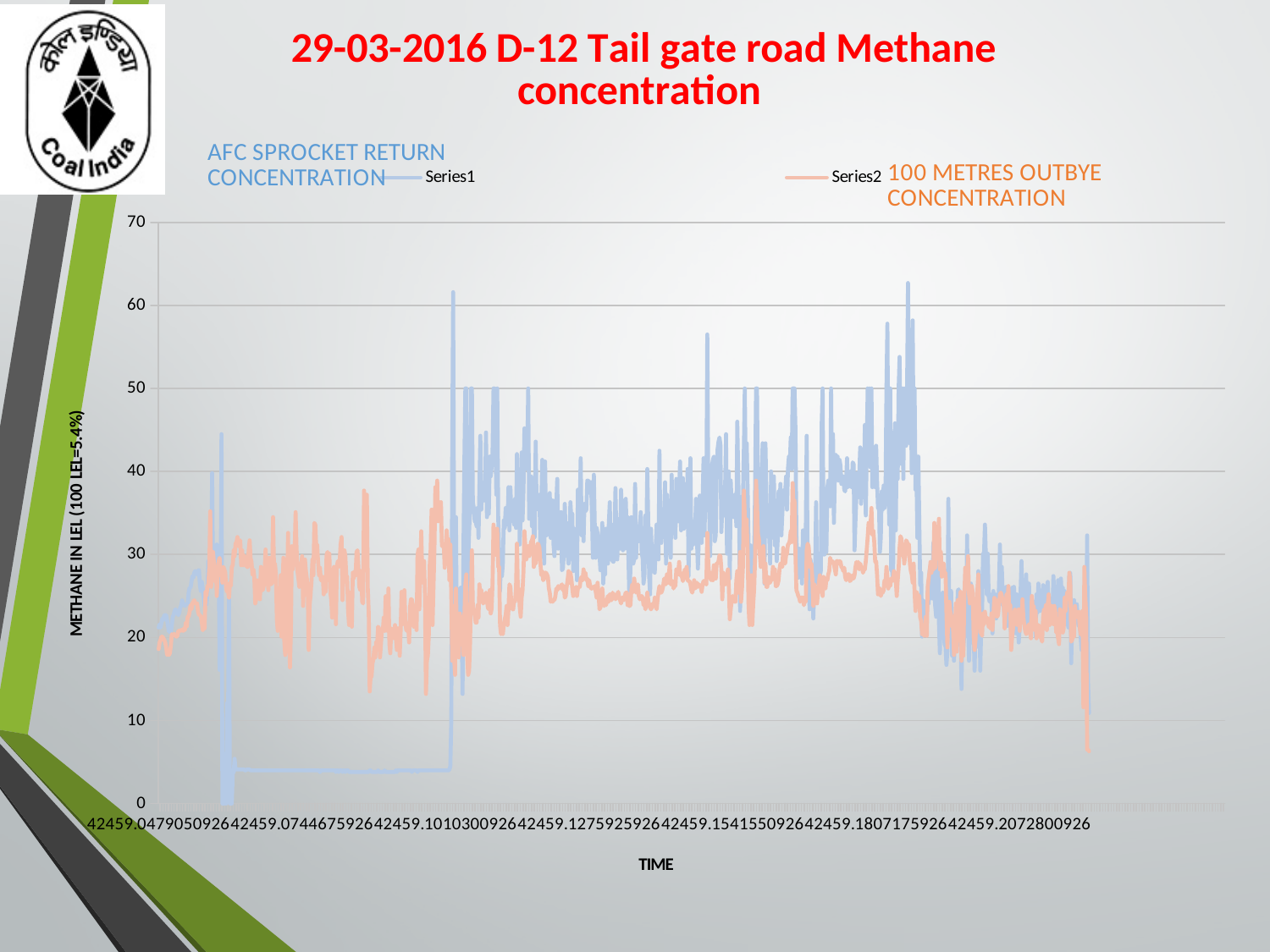
What is the maximum value shown on the vertical axis? 70 Is the value of Series2 at the start of the time axis greater or less than 30? less Is the highest value reached by Series2 greater or less than 50? less How many series does the chart's legend list? 2 What is the label of the vertical axis? METHANE IN LEL (100 LEL=5.4%) Is the highest value reached by Series1 greater or less than 60? greater What kind of chart is shown on the slide? line chart What is the title of the chart on the slide? 29-03-2016 D-12 Tail gate road Methane concentration Which series reaches the higher peak value, Series1 or Series2? Series1